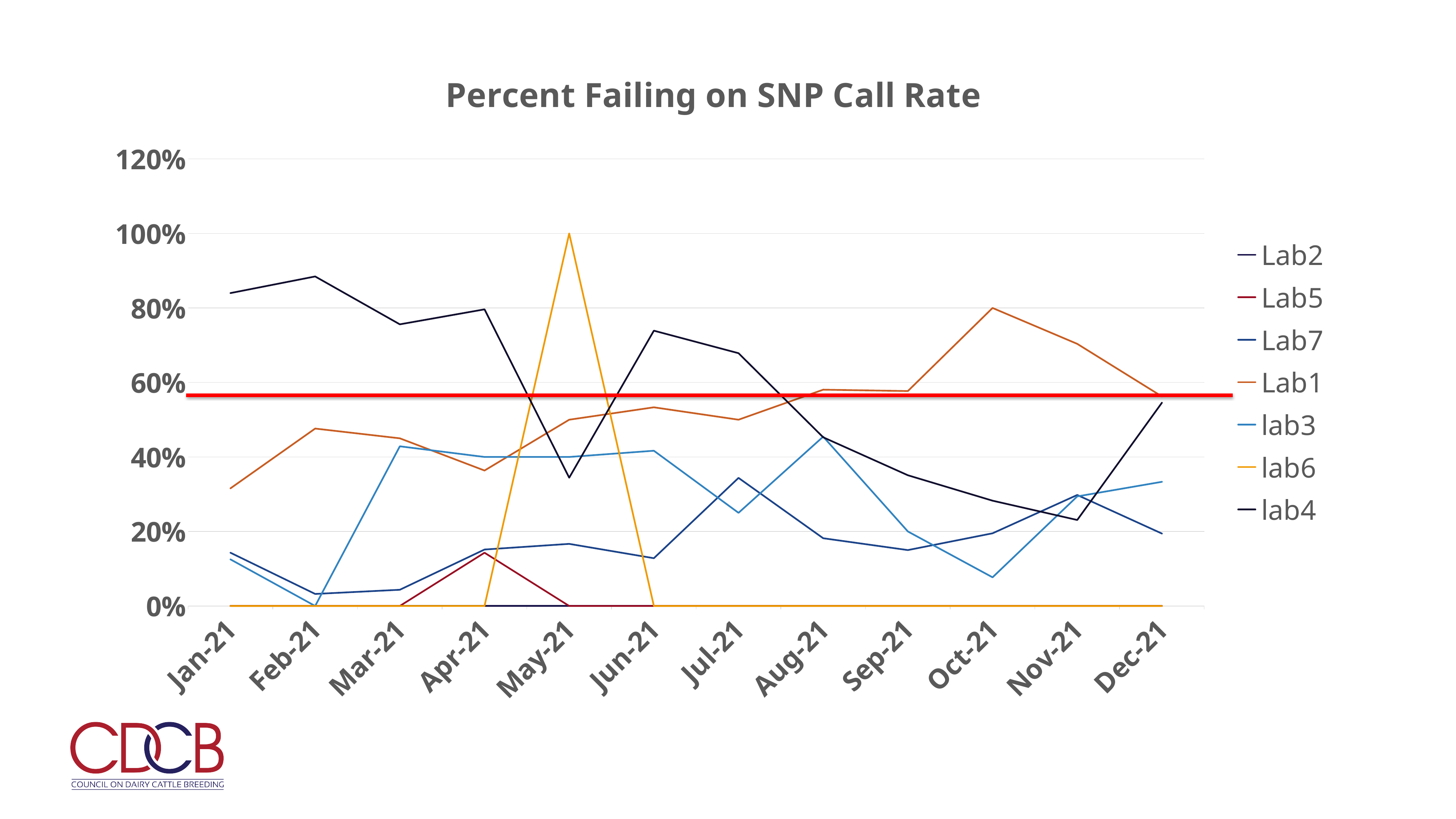
Which is larger in Jan-21, the value for lab4 or the value for Lab1? lab4 Is the value for lab4 in Feb-21 greater or less than 80%? greater How many series does the legend list? 7 Is the value for Lab1 in Oct-21 greater or less than 60%? greater How many months are shown on the x axis? 12 What is the title of the chart? Percent Failing on SNP Call Rate Which series reaches the highest value anywhere on the chart? lab6 Is the value for lab3 in Oct-21 greater or less than 20%? less What is the value for lab6 in May-21? 100% In which month does lab6 reach its highest value? May-21 Does the lab4 line rise or fall from Jun-21 to Nov-21? fall What kind of chart is shown on the slide? line chart